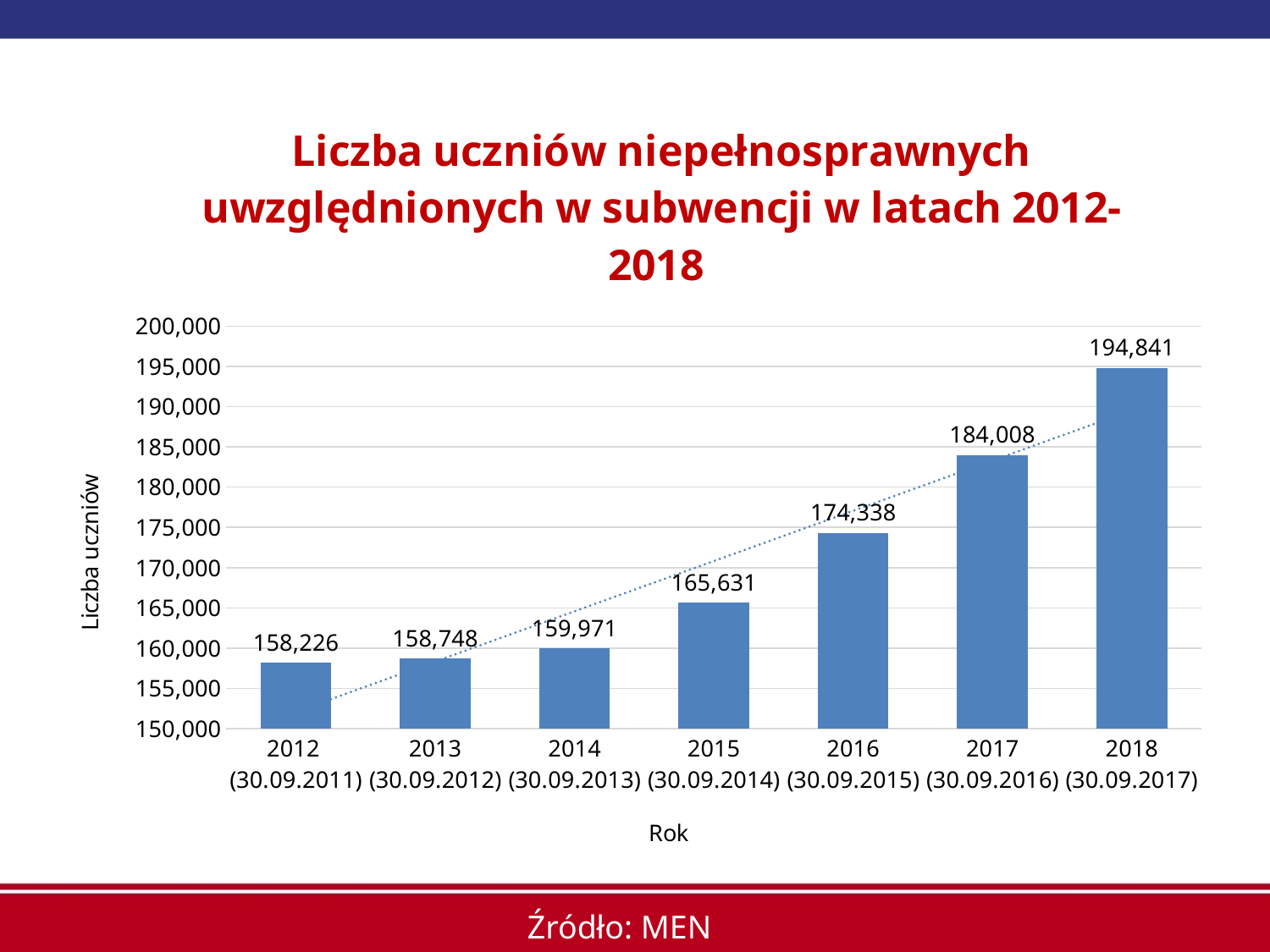
What is the difference between the values for 2017 and 2016? 9,670 Which is larger, the value for 2016 or the value for 2014? 2016 Which year has the lowest value? 2012 Which year has the highest value? 2018 What is the difference between the values for 2018 and 2012? 36,615 Do the values rise or fall from 2012 to 2018? rise How many years are shown on the x axis? 7 What is the value for 2012 (30.09.2011)? 158,226 What kind of chart is this? bar chart What is the value for 2018 (30.09.2017)? 194,841 Is the value for 2017 greater or less than 180,000? greater What is the value for 2015 (30.09.2014)? 165,631